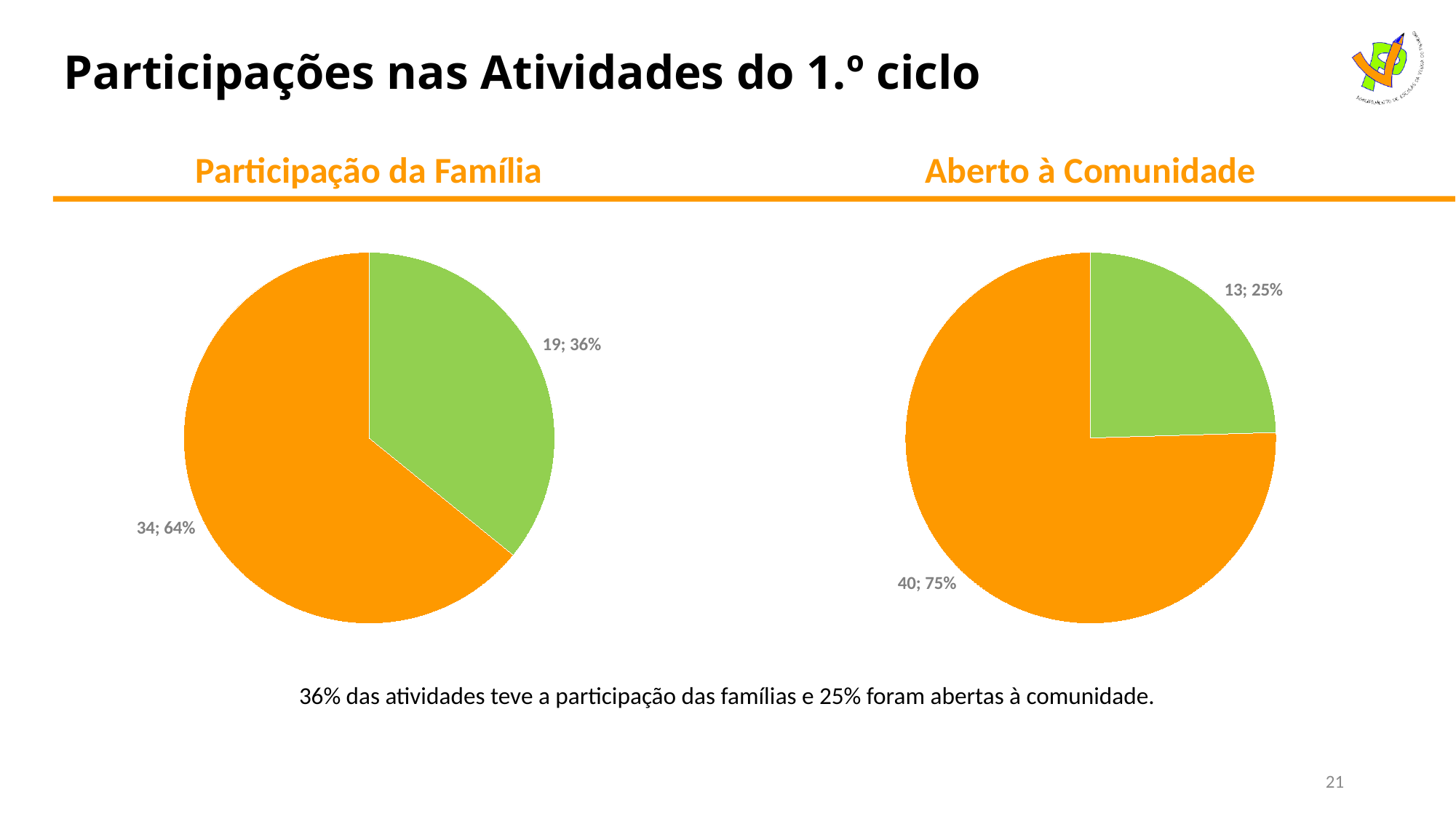
In the 'Participação da Família' chart, what share of the pie does the green slice represent? 36% In the 'Aberto à Comunidade' chart, what share of the pie does the orange slice represent? 75% What kind of chart is the 'Participação da Família' chart? pie chart In the 'Aberto à Comunidade' chart, which slice is the smallest? the green slice (13; 25%) In the 'Aberto à Comunidade' chart, what value is shown for the orange slice? 40; 75% In the 'Aberto à Comunidade' chart, what value is shown for the green slice? 13; 25% In the 'Participação da Família' chart, what value is shown for the green slice? 19; 36% In the 'Participação da Família' chart, what is the difference between the orange slice count and the green slice count? 15 In the 'Aberto à Comunidade' chart, what is the total of the two slice counts? 53 In the 'Participação da Família' chart, which slice is the largest? the orange slice (34; 64%) In the 'Participação da Família' chart, what value is shown for the orange slice? 34; 64% How many slices does the 'Aberto à Comunidade' pie chart have? 2